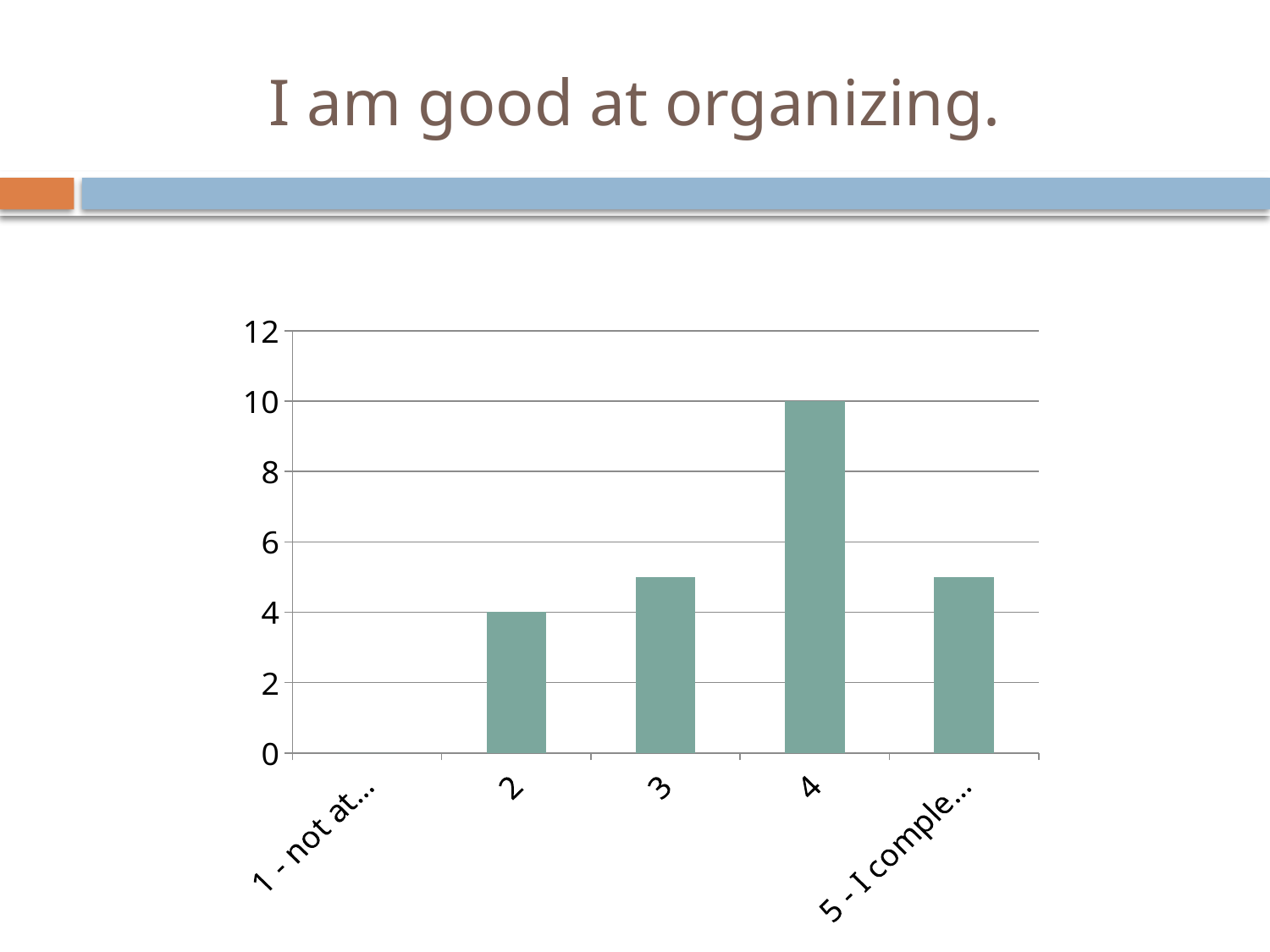
Which has a larger value, category 2 or category 4? 4 Which category has the highest value? 4 What is the title of the slide? I am good at organizing. Is the value for category 3 greater or less than 6? less What kind of chart is shown on the slide? bar chart How many categories are shown on the x axis? 5 Is the value for category 3 greater or less than 4? greater What is the difference between the values for category 4 and category 2? 6 Is the value for category 4 greater or less than 8? greater Which has a larger value, category 2 or category 3? 3 What is the value for category 4? 10 What is the value for category 2? 4